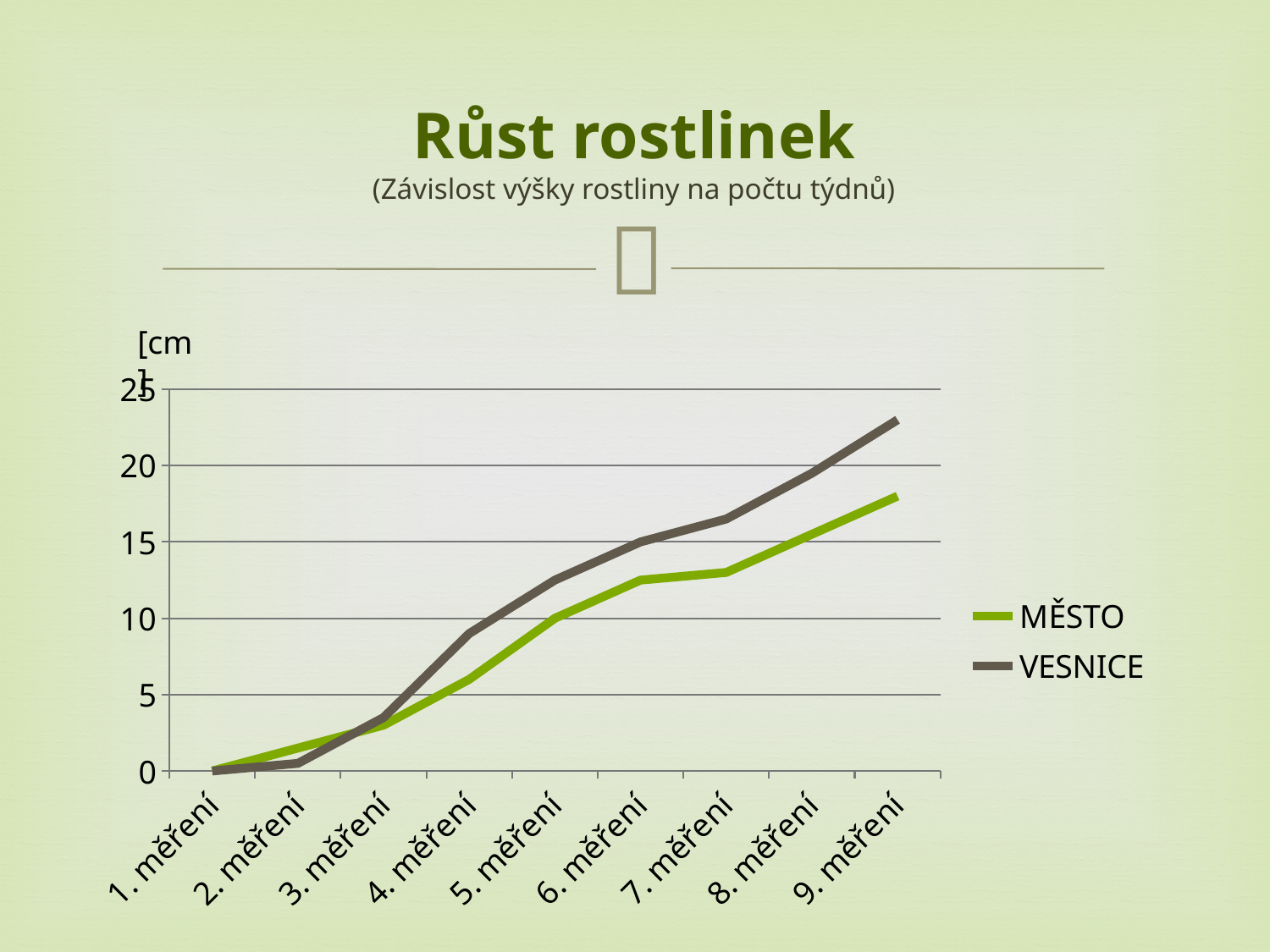
What is the title of the chart on the slide? Růst rostlinek Is the value for VESNICE at 2. měření greater or less than 5? less Is the value for MĚSTO at 7. měření greater or less than 10? greater How many measurements (categories) are shown on the x axis? 9 Do the values for VESNICE rise or fall from 1. měření to 9. měření? rise At 5. měření, which series has the larger value, MĚSTO or VESNICE? VESNICE Is the value for MĚSTO at 9. měření greater or less than 20? less Do the values for MĚSTO rise or fall across the measurements? rise At 9. měření, which series has the larger value, MĚSTO or VESNICE? VESNICE What kind of chart is shown on the slide? line chart How many series does the legend list? 2